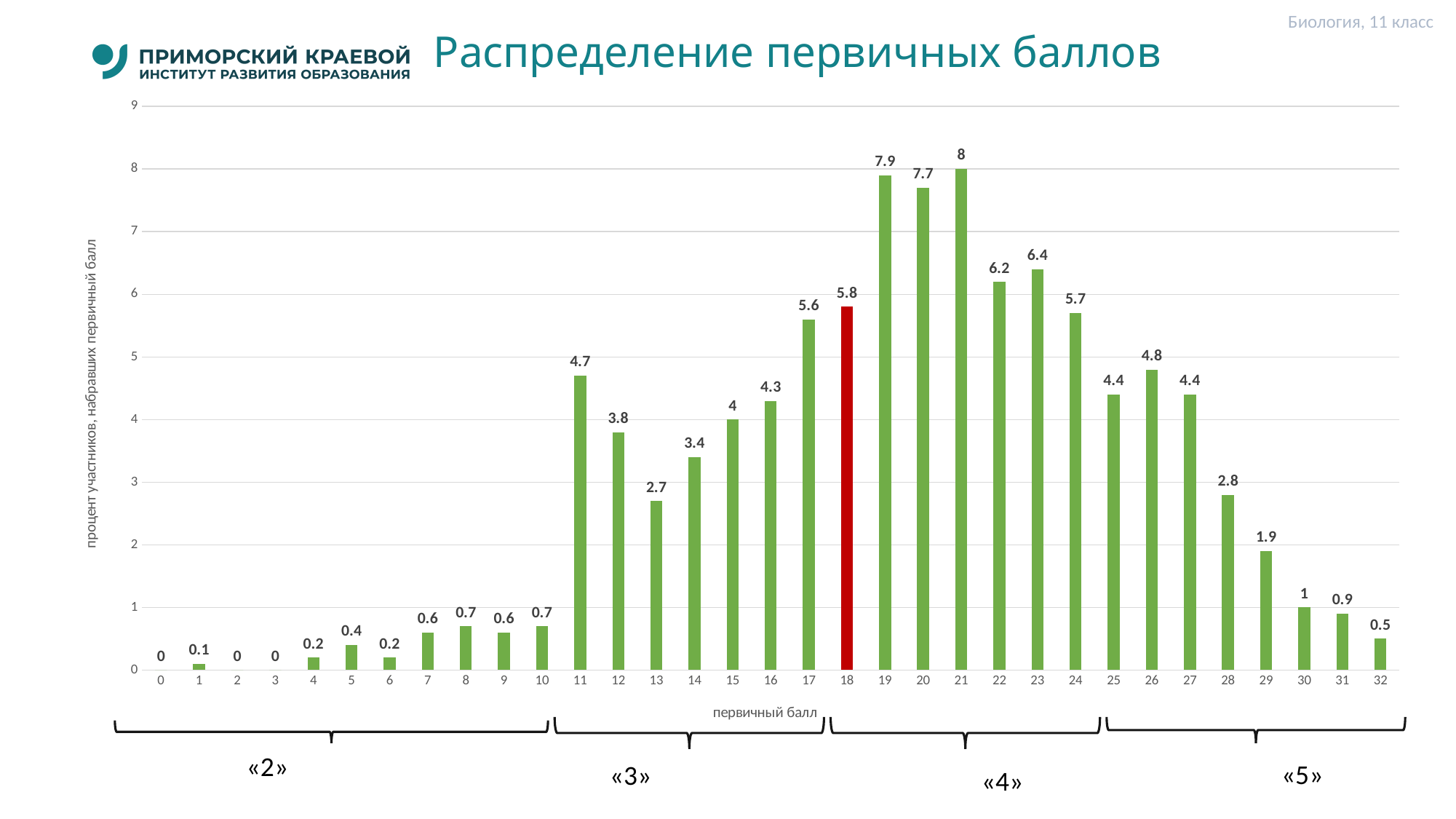
What is the value for primary score 18, shown by the red bar? 5.8 Which primary score is highlighted with a red bar? 18 Which is larger, the value for primary score 22 or for primary score 23? 23 Do the values rise or fall from primary score 27 to primary score 32? fall What is the value for primary score 11? 4.7 Which primary score has the highest value? 21 What is the value for primary score 21? 8 What is the difference between the values for primary scores 19 and 20? 0.2 What kind of chart is shown on the slide? bar chart How many primary score categories are shown on the x axis? 33 What is the difference between the values for primary scores 17 and 13? 2.9 What is the title of the chart? Распределение первичных баллов